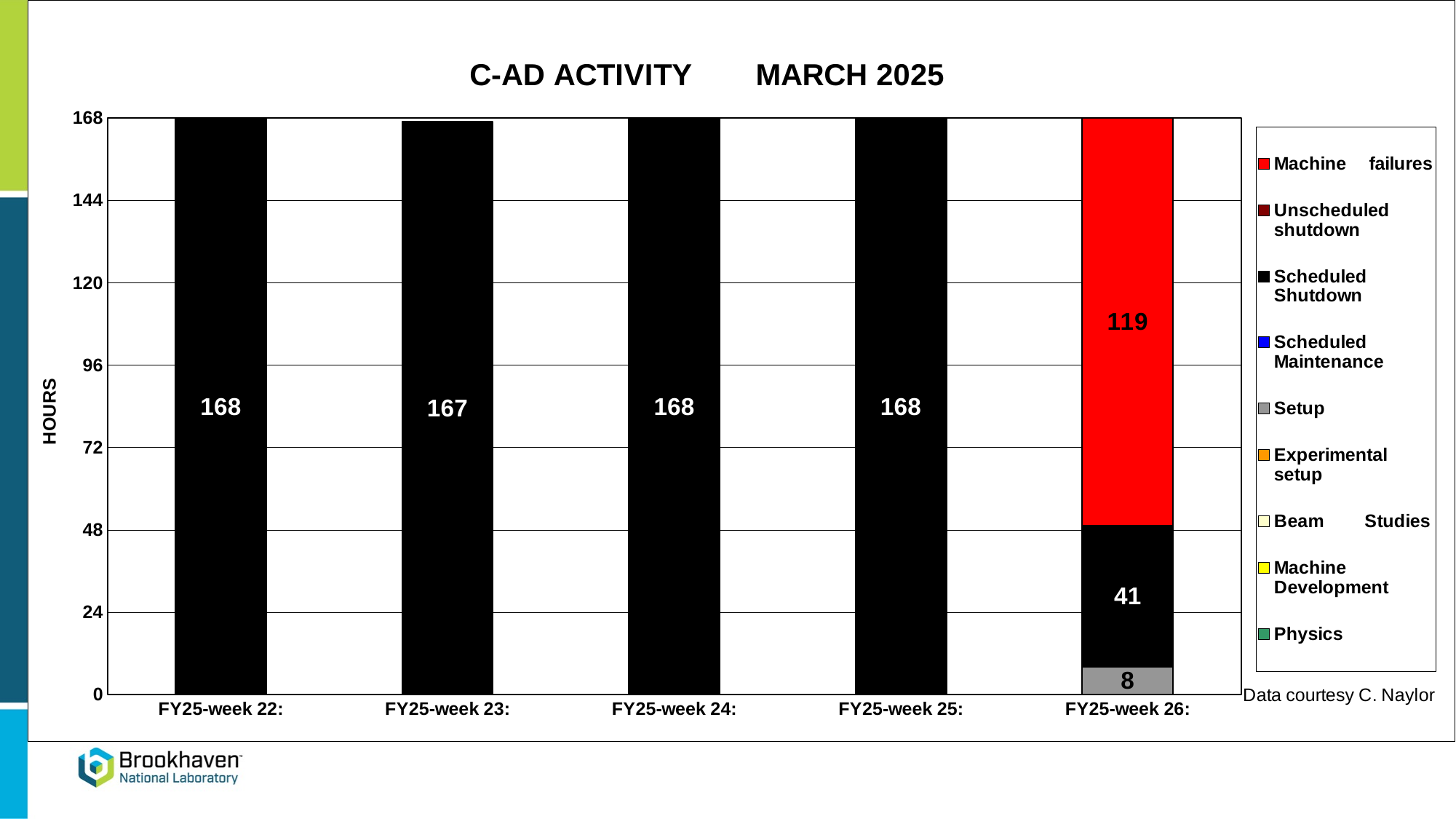
What is the difference between the Machine failures hours and the Scheduled Shutdown hours in FY25-week 26? 78 What kind of chart is shown on the slide? Stacked bar chart What is the total height of the stacked bar for FY25-week 26? 168 What is the Scheduled Shutdown value for FY25-week 23? 167 What is the Setup value for FY25-week 26? 8 What is the Scheduled Shutdown value for FY25-week 26? 41 Which is larger in FY25-week 26: Machine failures or Setup? Machine failures What is the label of the y axis? HOURS What is the Machine failures value for FY25-week 26? 119 How many weeks are shown on the x axis? 5 Which week has the lowest Scheduled Shutdown hours? FY25-week 26: How many series does the legend list? 9